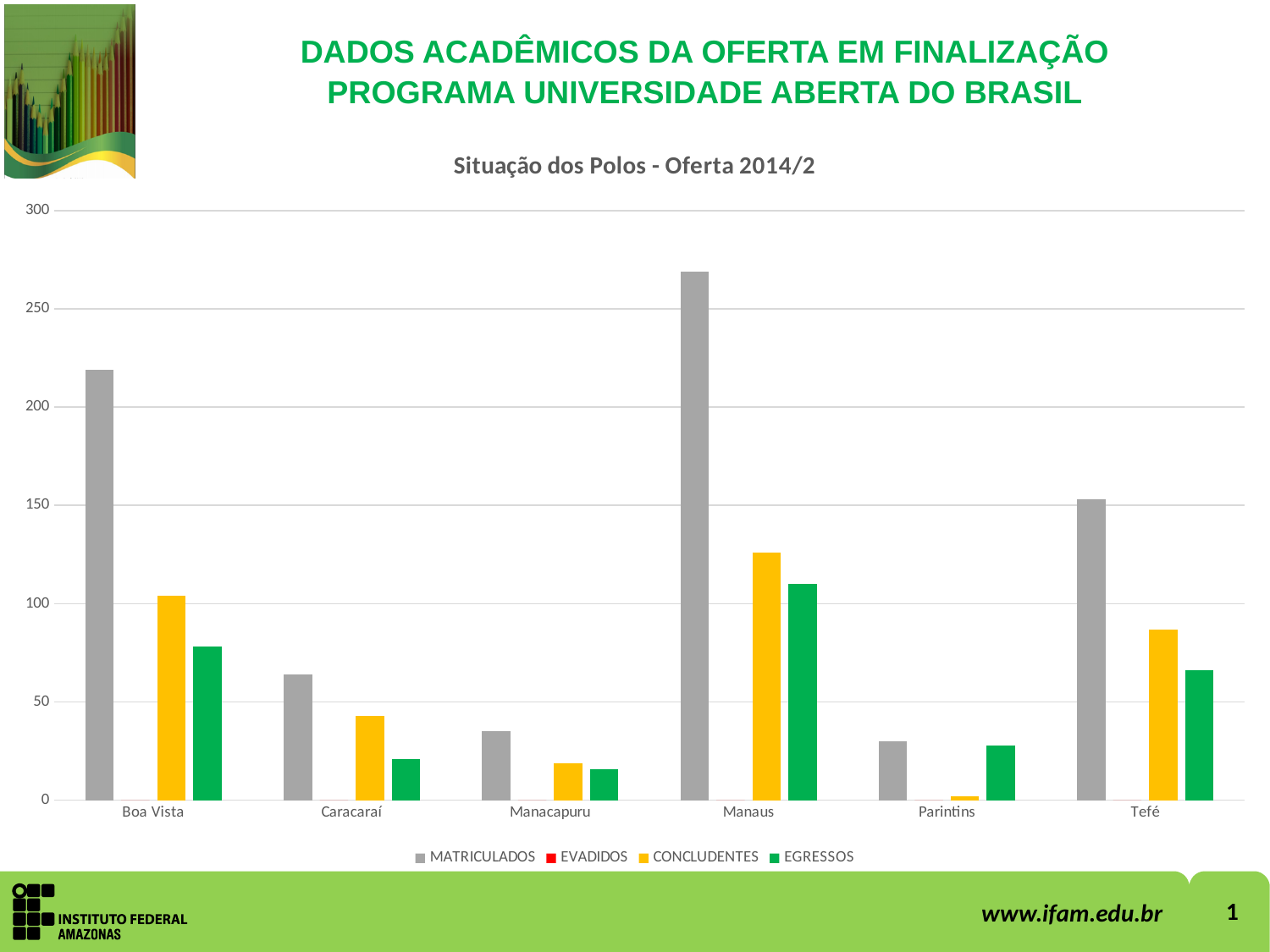
What kind of chart is shown on the slide? bar chart What is the title of the chart? Situação dos Polos - Oferta 2014/2 Is the MATRICULADOS value for Boa Vista greater or less than 200? greater Which polo has the lowest CONCLUDENTES value? Parintins How many polos (categories) are shown on the x axis of the chart? 6 Is the MATRICULADOS value for Manaus greater or less than 250? greater Which polo has the larger MATRICULADOS value, Boa Vista or Tefé? Boa Vista Is the CONCLUDENTES value for Tefé greater or less than 100? less Which polo has the highest MATRICULADOS value? Manaus For Manaus, which is larger, CONCLUDENTES or EGRESSOS? CONCLUDENTES How many series does the chart legend list? 4